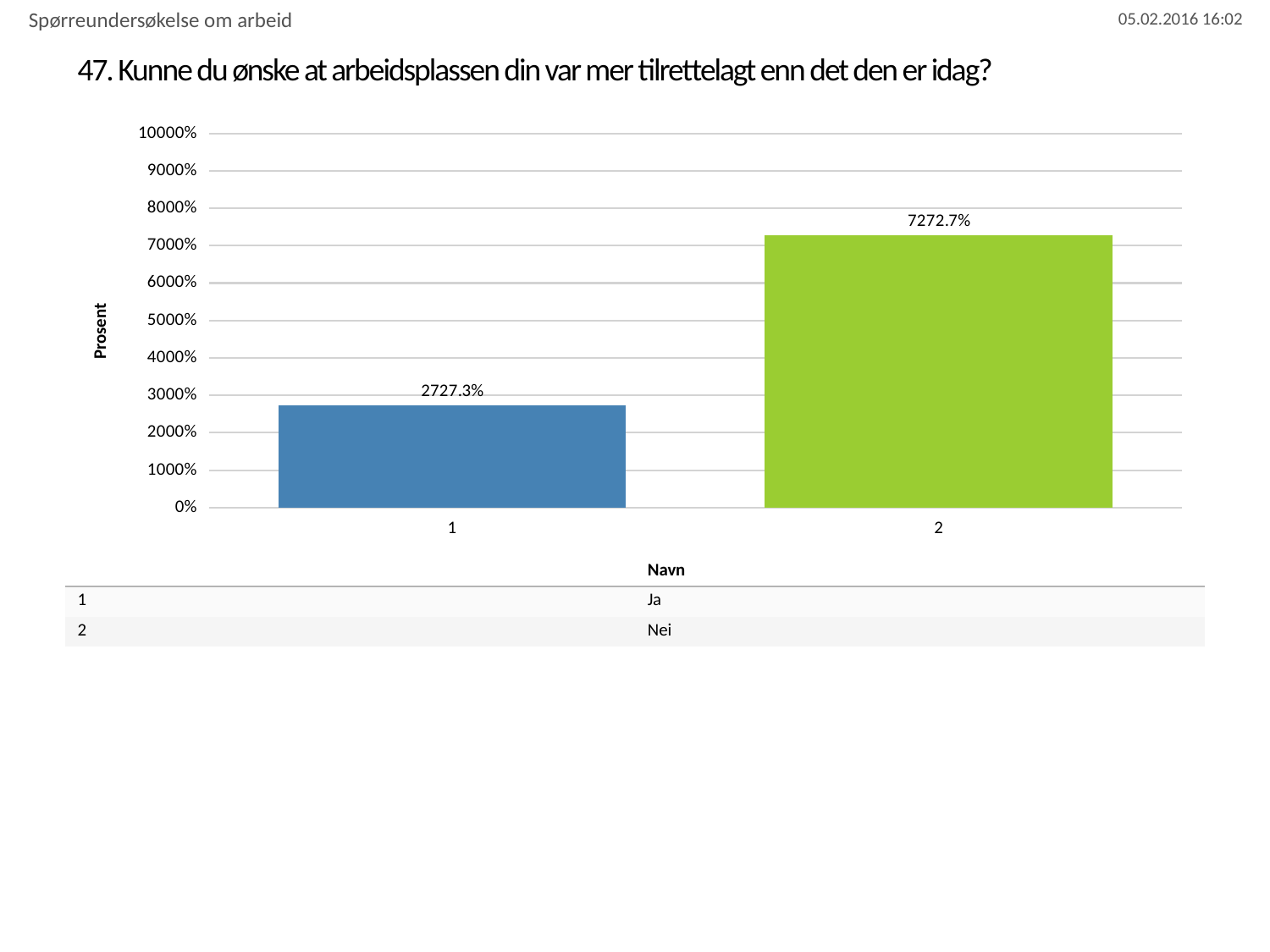
Which category has the highest value? 2 What is the label of the y axis? Prosent What is the value for category 1? 2727.3% What is the difference between the values for category 2 and category 1? 4545.4% Which category has the lowest value? 1 Which is larger, the value for category 1 or category 2? 2 According to the table below the chart, what name corresponds to category 2? Nei Is the value for category 1 greater or less than 3000%? less Is the value for category 2 greater or less than 7000%? greater What is the value for category 2? 7272.7% What kind of chart is shown on the slide? bar chart How many categories are shown on the x axis? 2